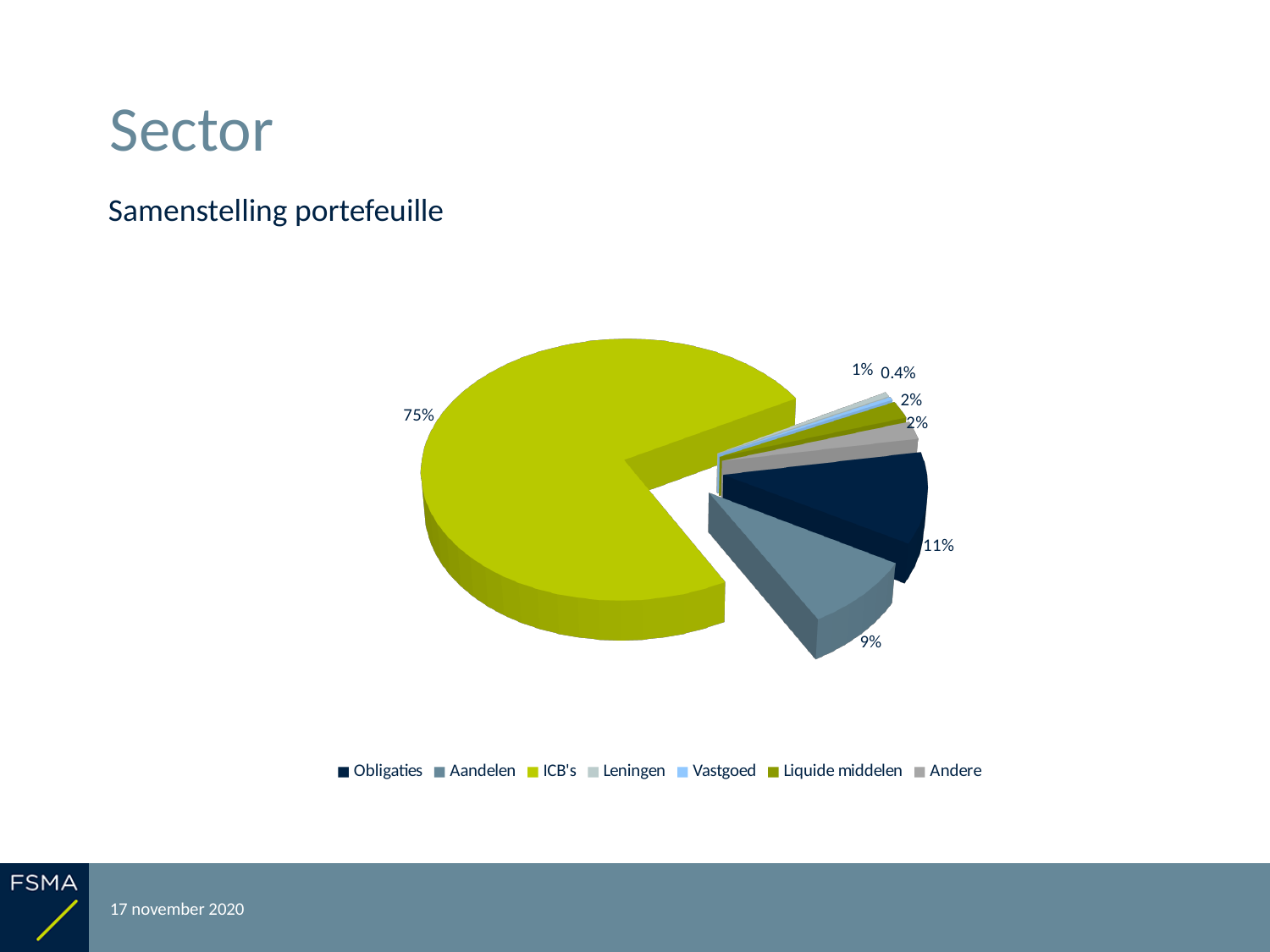
What share of the portfolio is Obligaties? 11% What share of the portfolio is Aandelen? 9% What share of the portfolio is Leningen? 1% Which category has the smallest slice of the pie? Vastgoed How many categories does the legend list? 7 Which is larger, the share for Obligaties or the share for Aandelen? Obligaties What is the title of the chart? Samenstelling portefeuille Which category has the largest slice of the pie? ICB's What share of the portfolio is ICB's? 75% What kind of chart is shown on the slide? pie chart What share of the portfolio is Vastgoed? 0.4% How many percentage points larger is the ICB's share than the Obligaties share? 64 percentage points